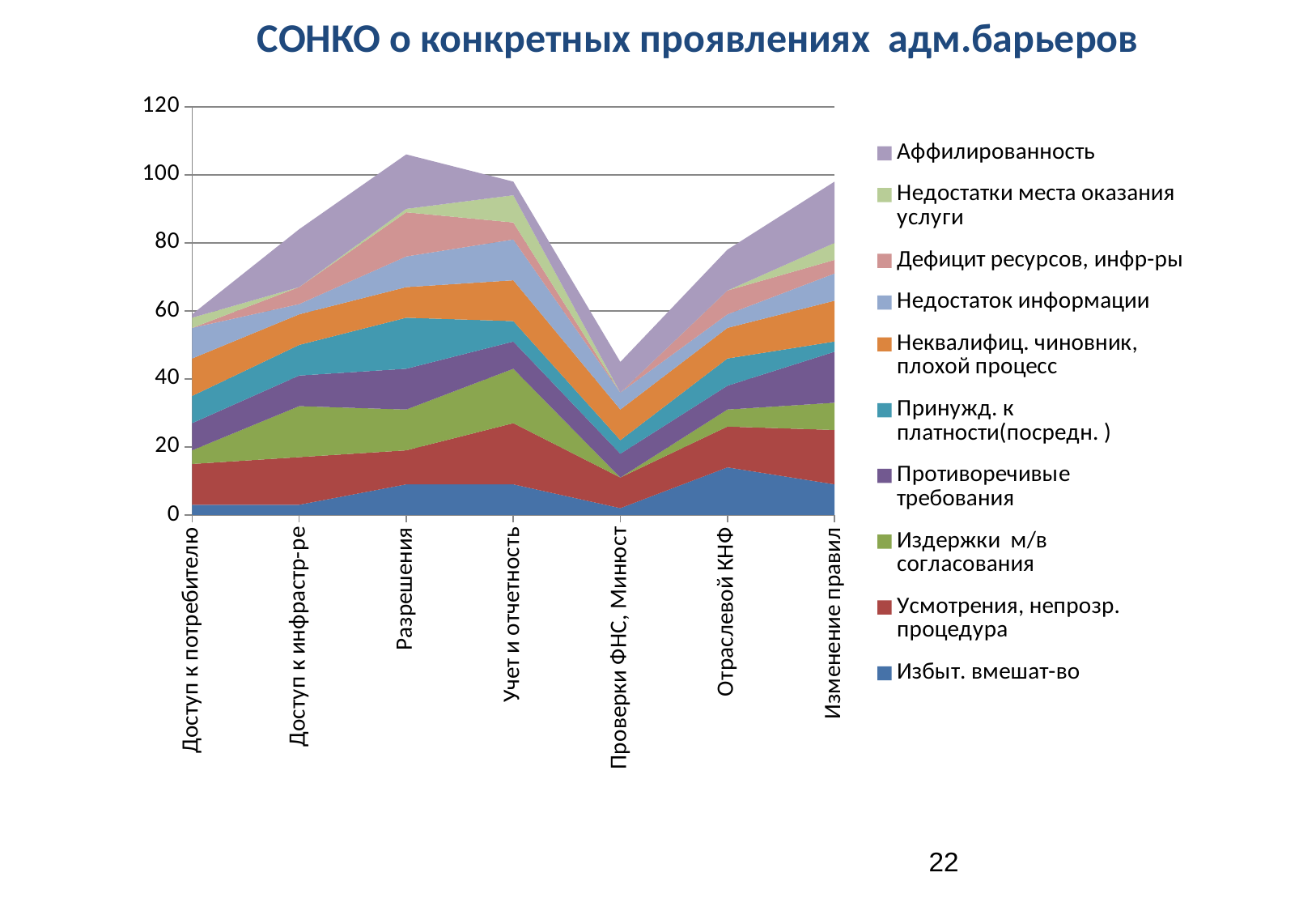
Which category has the lowest stacked total? Проверки ФНС, Минюст What is the title of the slide? СОНКО о конкретных проявлениях адм.барьеров How many categories are shown along the x axis? 7 What kind of chart is shown on the slide? Stacked area chart Is the stacked total for Проверки ФНС, Минюст greater or less than 60? less How many series does the legend list? 10 Is the stacked total for Отраслевой КНФ greater or less than 60? greater Which series is shown at the bottom of the stack in blue? Избыт. вмешат-во Which category has the highest stacked total? Разрешения Is the stacked total for Разрешения greater or less than 100? greater Does the stacked total rise or fall from Учет и отчетность to Проверки ФНС, Минюст? fall